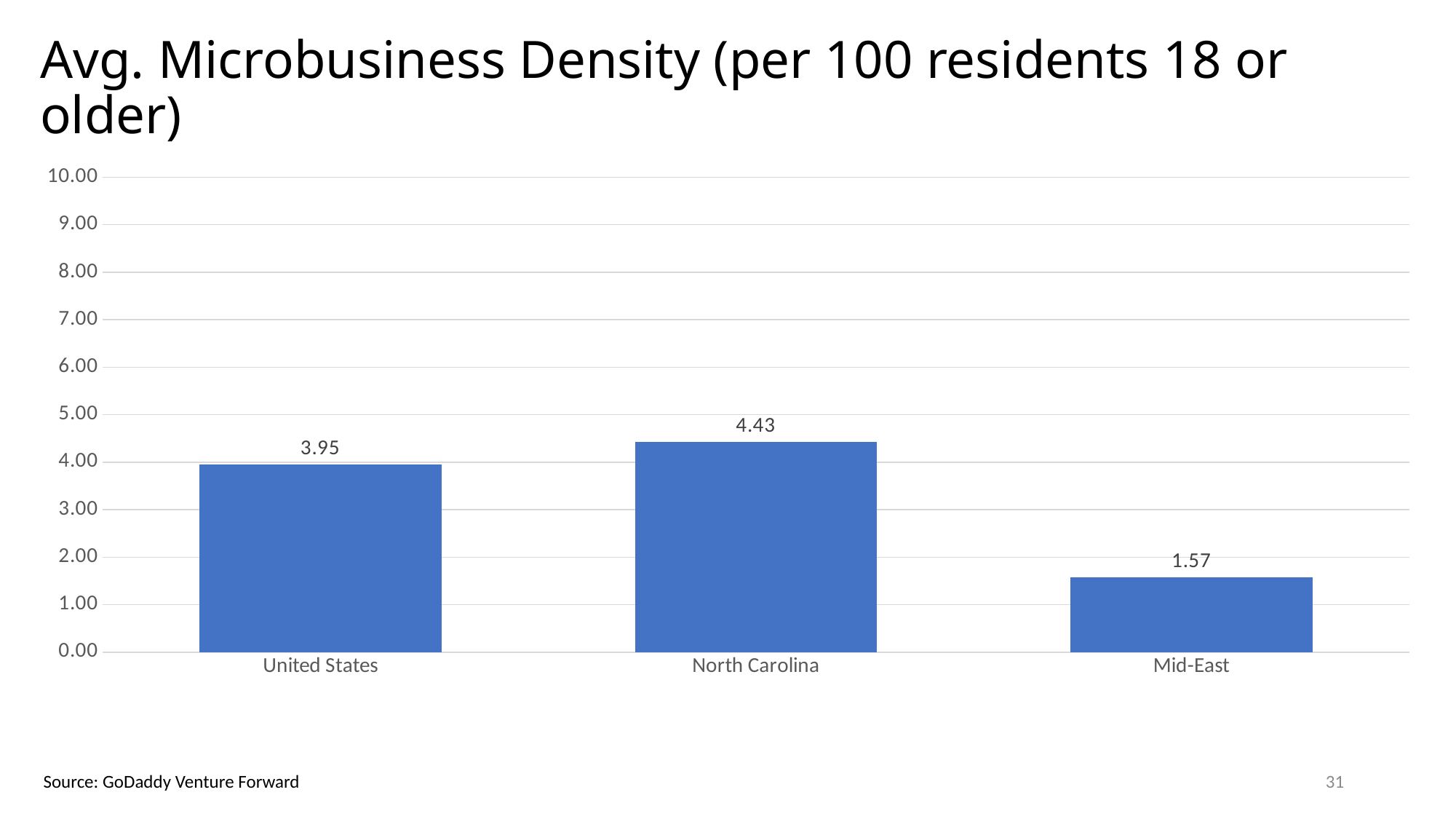
Is the value for Mid-East greater or less than 2.00? less What is the average microbusiness density for Mid-East? 1.57 What is the difference between the United States and Mid-East values? 2.38 What kind of chart is shown on the slide? bar chart Which category has the lowest average microbusiness density? Mid-East Which is larger, the value for North Carolina or the value for Mid-East? North Carolina What is the source cited for the chart? GoDaddy Venture Forward What is the difference between the North Carolina and United States values? 0.48 What is the average microbusiness density for the United States? 3.95 How many categories are shown in the chart? 3 Which category has the highest average microbusiness density? North Carolina What is the average microbusiness density for North Carolina? 4.43